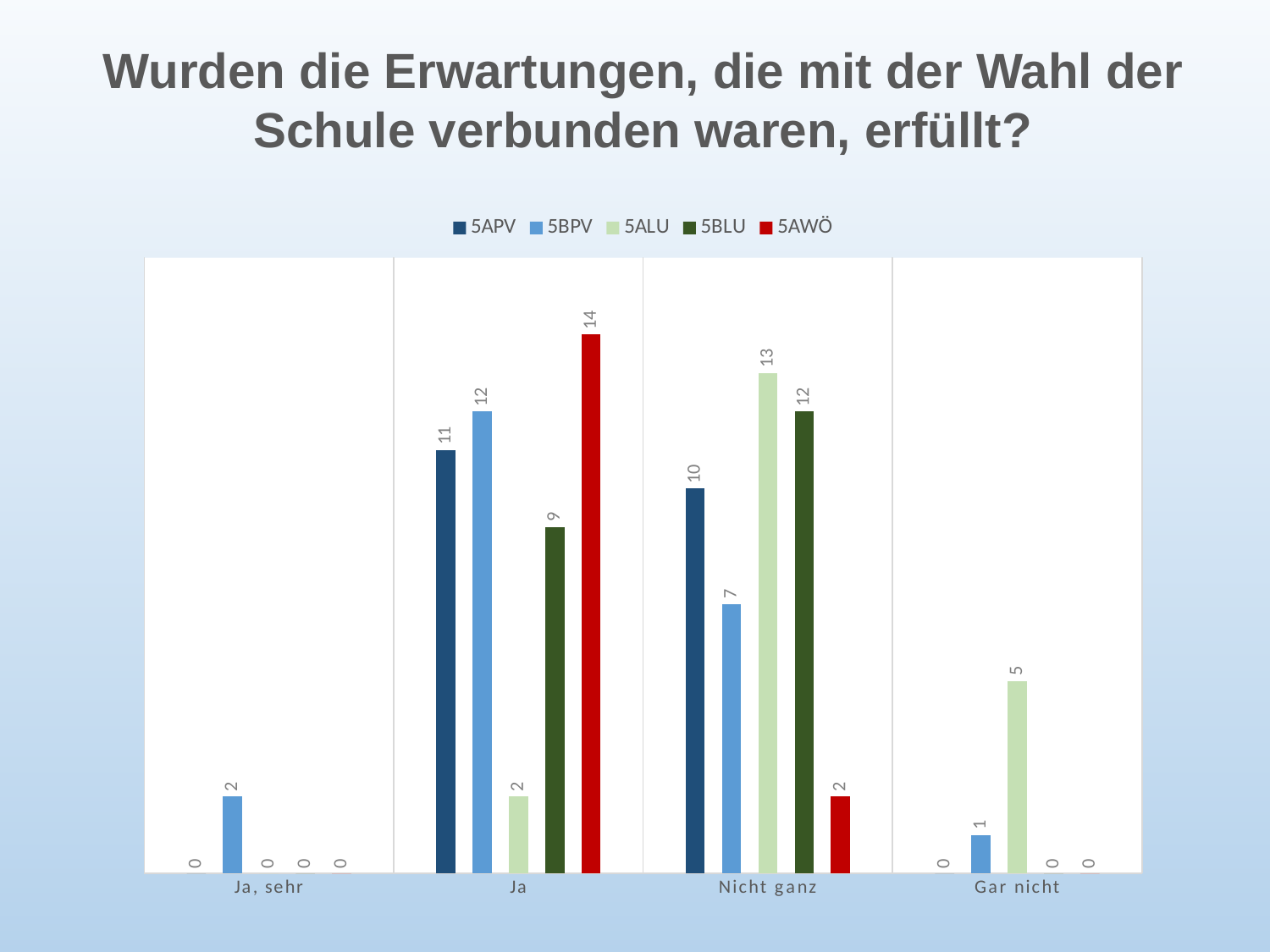
What is the difference between the 5BPV value and the 5ALU value in the category "Ja"? 10 Which series has the highest value in the category "Ja"? 5AWÖ What kind of chart is shown on the slide? bar chart Which series has the lowest value in the category "Nicht ganz"? 5AWÖ What is the value for 5ALU in the category "Gar nicht"? 5 How many series does the legend list? 5 Which is larger in the category "Nicht ganz": the value for 5APV or the value for 5BPV? 5APV What is the value for 5BPV in the category "Ja, sehr"? 2 What is the value for 5ALU in the category "Nicht ganz"? 13 Which series is shown in red in the legend? 5AWÖ What is the value for 5AWÖ in the category "Ja"? 14 How many categories are shown on the x axis? 4